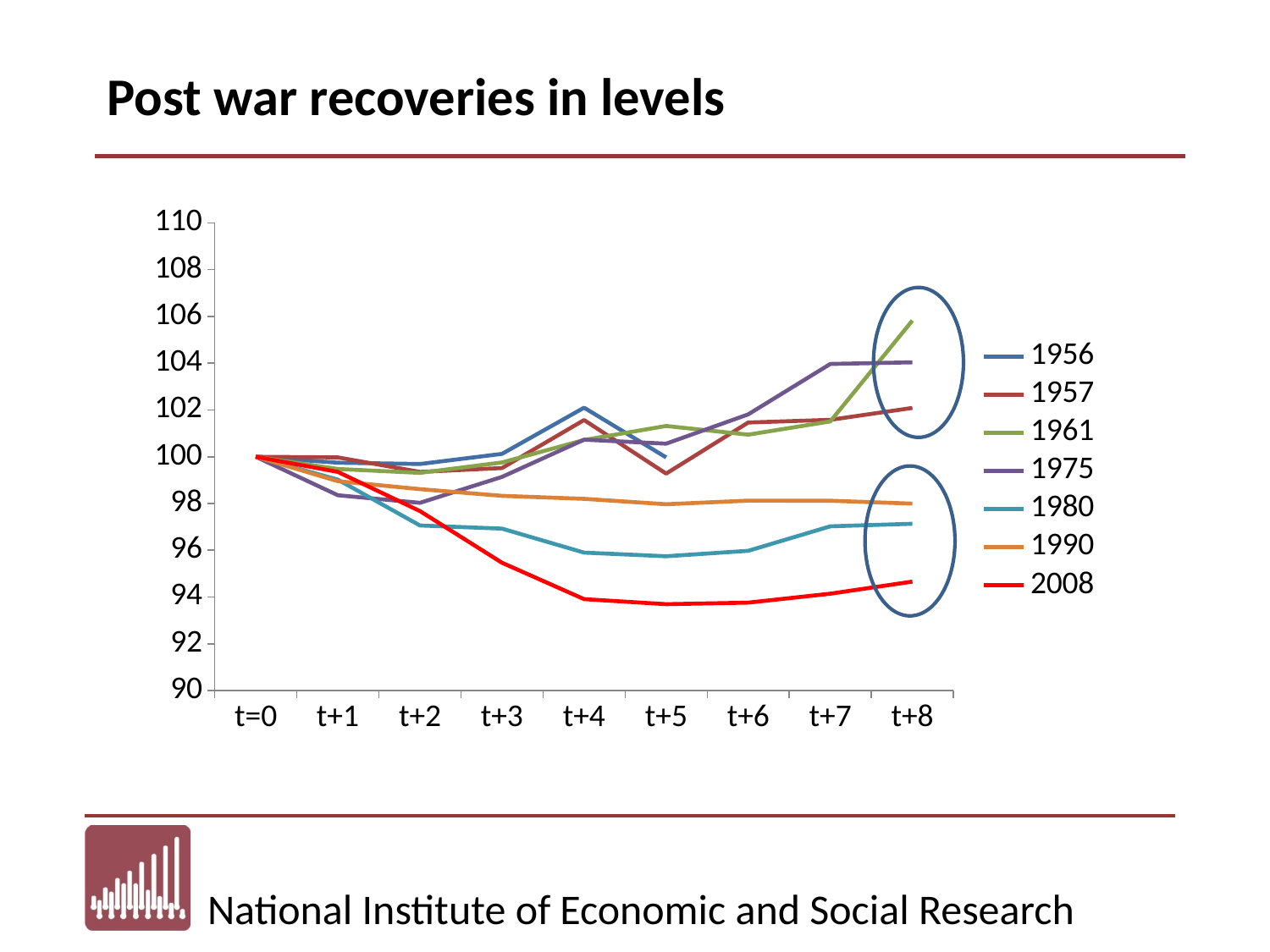
Is the value for the 1990 series at t+8 greater or less than 100? less Which series has the highest value at t+8? 1961 What kind of chart is shown on the slide? line chart How many points are on the x axis, from t=0 to t+8? 9 What is the value of the 2008 series at t=0? 100 Is the value for the 1961 series at t+8 greater or less than 104? greater Is the value for the 2008 series at t+8 greater or less than 96? less How many series does the legend list? 7 What is the title of the chart? Post war recoveries in levels At t+8, which is larger: the 1980 series or the 2008 series? 1980 Does the 2008 series rise or fall from t=0 to t+4? fall Which series has the lowest value at t+8? 2008